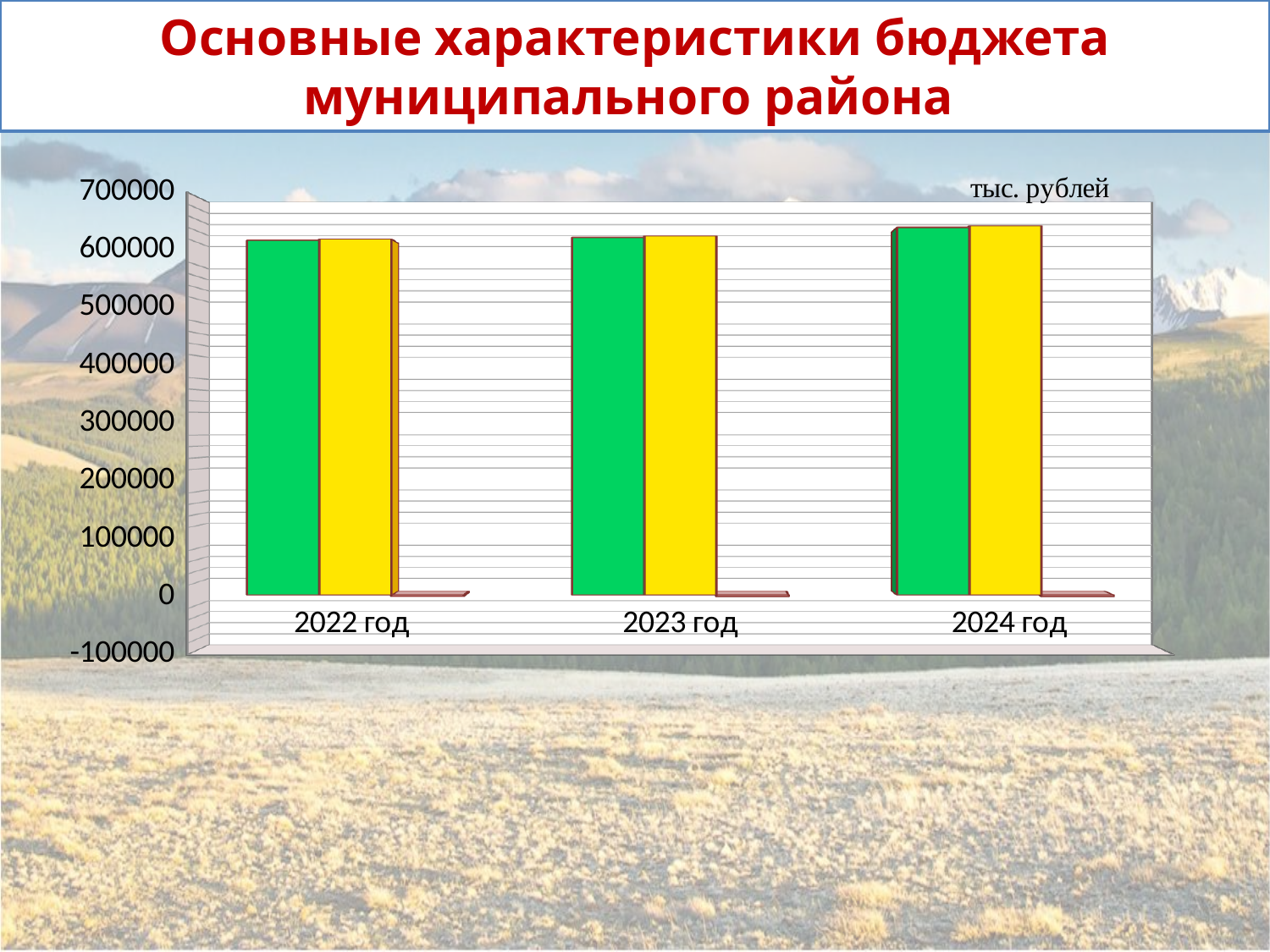
Is the value of the green bar for 2022 год greater or less than 500000? greater Do the green bars rise or fall from 2022 год to 2024 год? rise Is the value of the yellow bar for 2023 год greater or less than 700000? less What unit of measurement is indicated in the top right corner of the chart? тыс. рублей How many year categories are shown on the x axis of the chart? 3 Which year has the tallest green bar? 2024 год What is the title of the slide containing the chart? Основные характеристики бюджета муниципального района What kind of chart is shown on the slide? bar chart Is the value of the yellow bar for 2022 год greater or less than 400000? greater What is the lowest value shown on the vertical axis of the chart? -100000